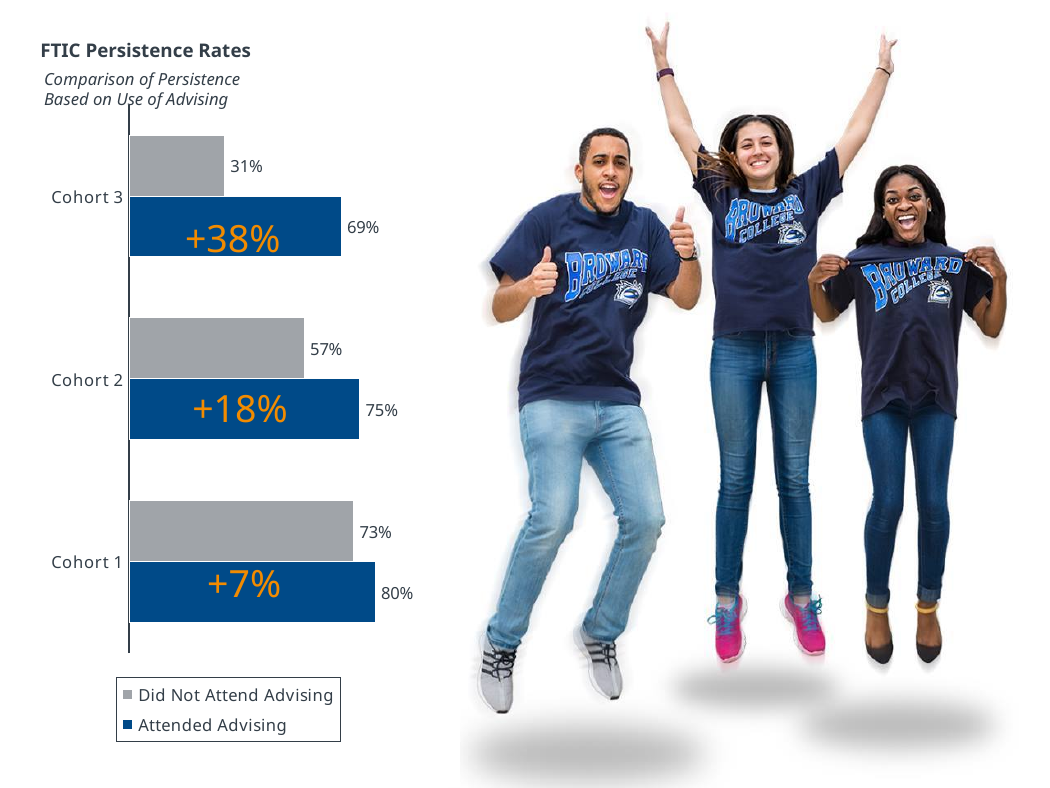
What is the persistence rate for Cohort 3 students who attended advising? 69% What is the persistence rate for Cohort 1 students who attended advising? 80% Which cohort has the highest persistence rate among students who attended advising? Cohort 1 What is the title of the chart? FTIC Persistence Rates What is the persistence rate for Cohort 2 students who did not attend advising? 57% What type of chart is shown on the slide? Bar chart How many cohorts are shown in the chart? 3 What is the persistence rate for Cohort 3 students who did not attend advising? 31% For Cohort 1, which is larger: the persistence rate for students who attended advising or those who did not? Attended Advising How many series does the legend list? 2 What is the difference between the Attended Advising and Did Not Attend Advising persistence rates for Cohort 2? 18% Which cohort has the lowest persistence rate among students who did not attend advising? Cohort 3